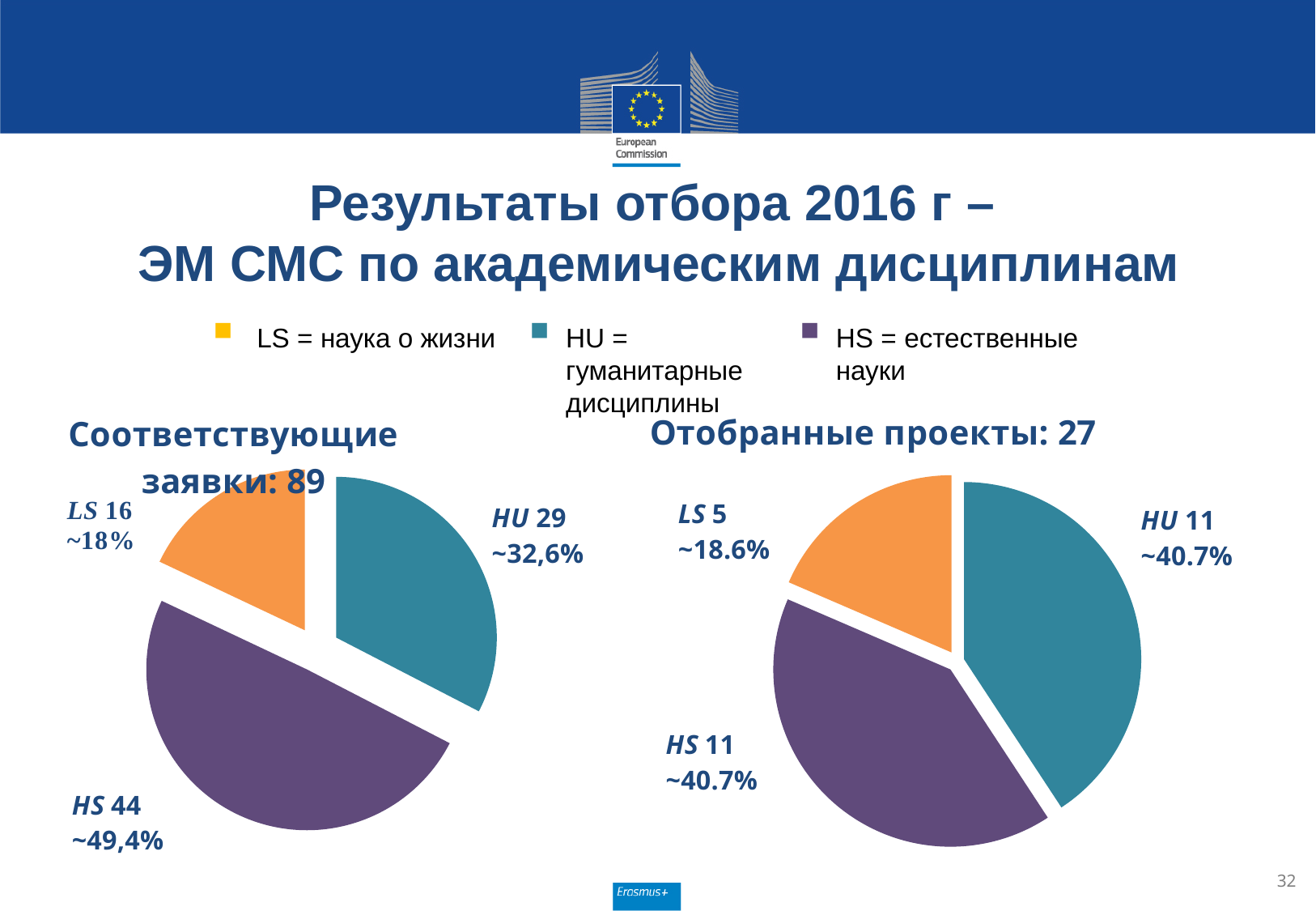
What type of chart is used on this slide? Pie chart In the left pie chart (Соответствующие заявки: 89), which discipline has the largest slice? HS In the right pie chart (Отобранные проекты: 27), what is the difference between the HU and LS values? 6 In the right pie chart (Отобранные проекты: 27), how many projects are shown for HU? 11 In the right pie chart (Отобранные проекты: 27), which discipline has the smallest slice? LS In the left pie chart (Соответствующие заявки: 89), what is the difference between the HS and HU values? 15 In the left pie chart (Соответствующие заявки: 89), how many applications are shown for HS? 44 How many slices does the right pie chart (Отобранные проекты: 27) have? 3 In the left pie chart (Соответствующие заявки: 89), which is larger, the value for HU or the value for LS? HU In the left pie chart (Соответствующие заявки: 89), how many applications are shown for HU? 29 In the right pie chart (Отобранные проекты: 27), how many projects are shown for LS? 5 In the left pie chart (Соответствующие заявки: 89), which discipline has the smallest slice? LS